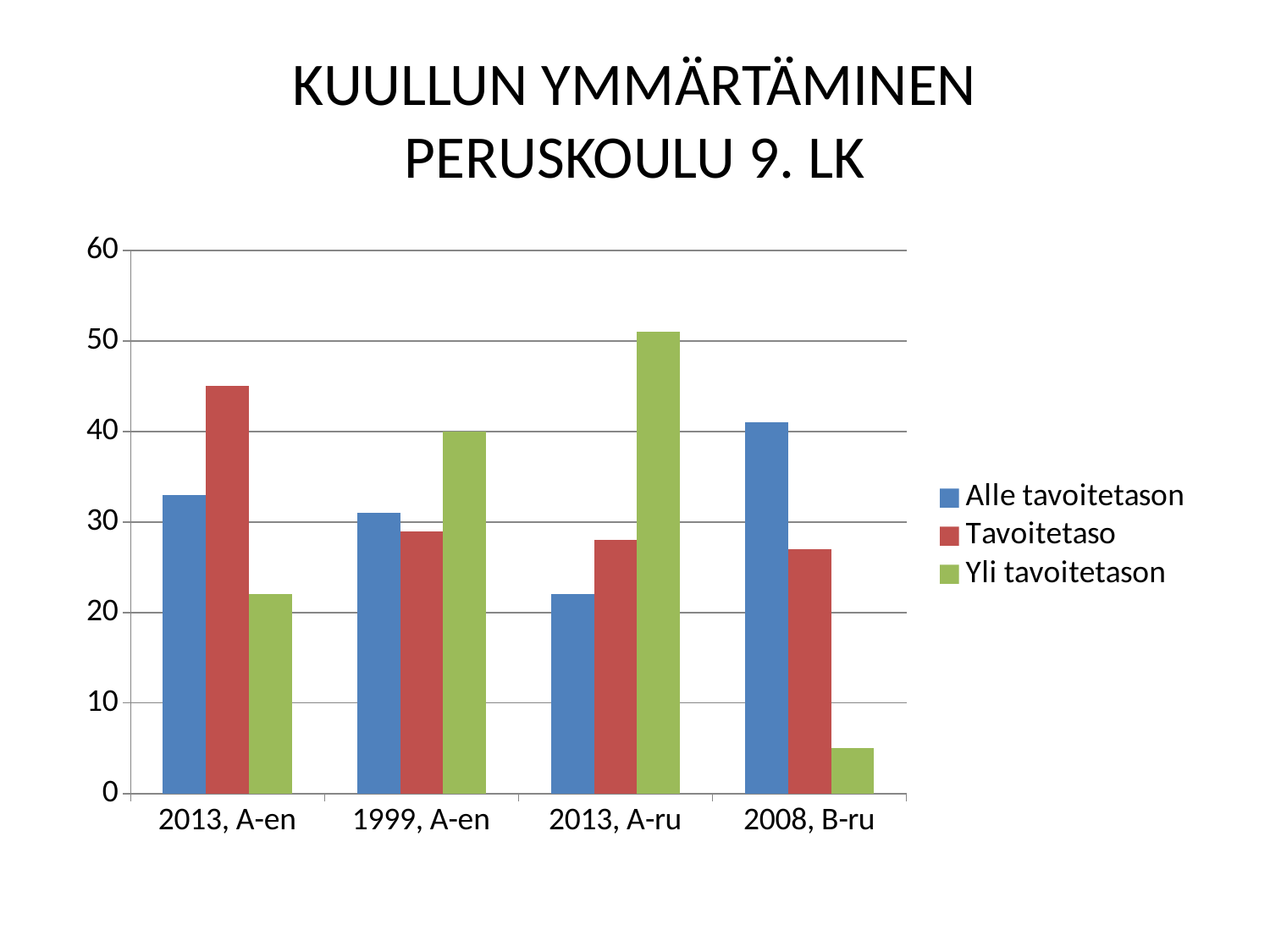
Which category has the highest Yli tavoitetason bar? 2013, A-ru How many categories are shown on the x axis? 4 What kind of chart is shown on the slide? bar chart Which category has the highest Alle tavoitetason bar? 2008, B-ru Which category has the lowest Yli tavoitetason bar? 2008, B-ru For 2013, A-en, which is larger: Alle tavoitetason or Yli tavoitetason? Alle tavoitetason How many series does the legend list? 3 Is the Yli tavoitetason value for 2008, B-ru greater or less than 10? less Is the Tavoitetaso value for 2013, A-en greater or less than 40? greater Which category has the highest Tavoitetaso bar? 2013, A-en Which colour represents the Tavoitetaso series? red